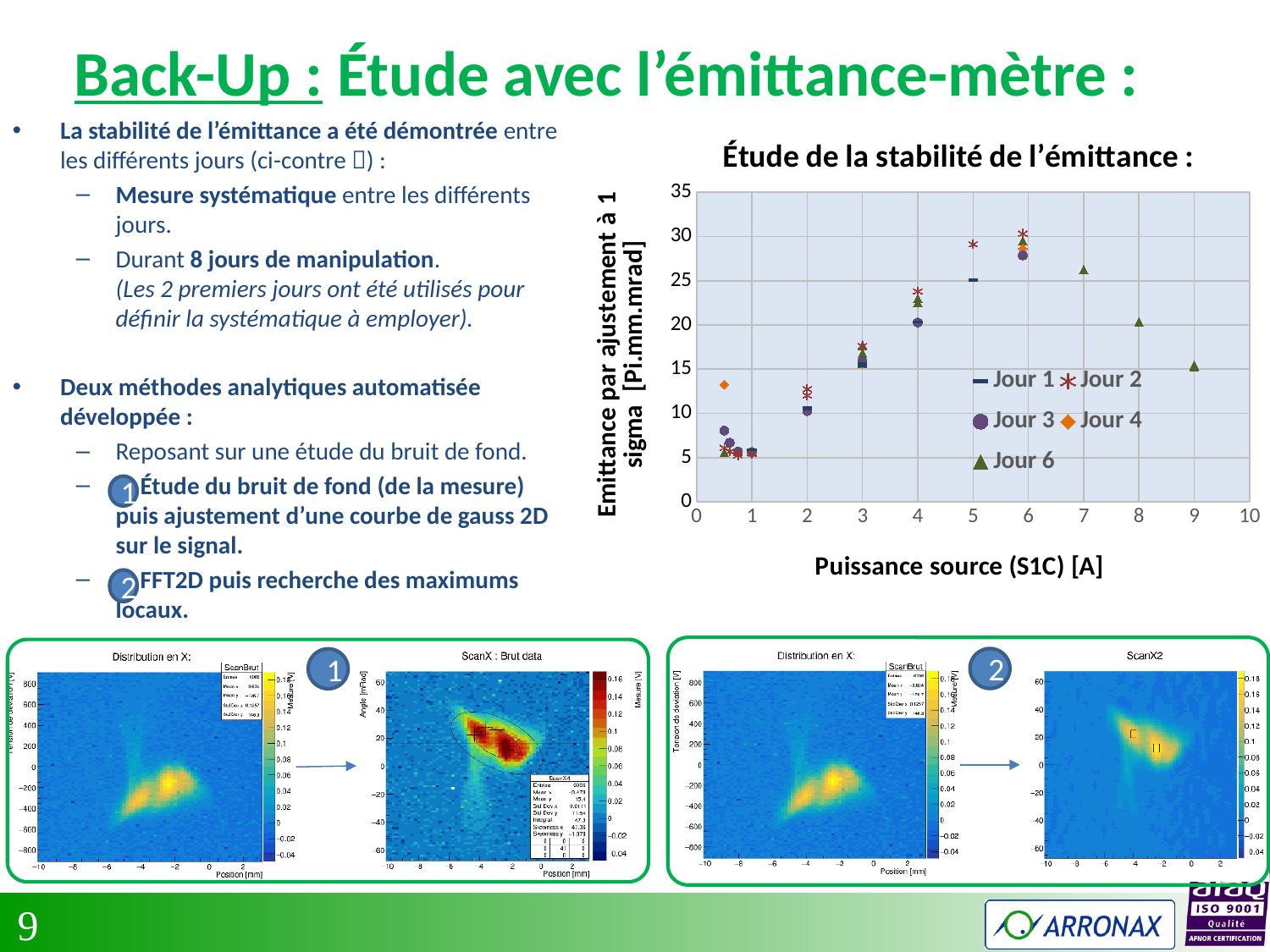
In the 'Étude de la stabilité de l'émittance' chart, do the Jour 2 values rise or fall as the source power increases from 1 to 6? rise In the 'Étude de la stabilité de l'émittance' chart, is the Jour 6 value at x = 7 greater or less than 25? greater What kind of chart is 'Étude de la stabilité de l'émittance'? Scatter chart In the 'Étude de la stabilité de l'émittance' chart, is the Jour 2 value at x = 3 greater or less than 15? greater In the 'Étude de la stabilité de l'émittance' chart, is the Jour 2 value at x = 5 greater or less than 25? greater Which series are listed in the legend of the 'Étude de la stabilité de l'émittance' chart? Jour 1, Jour 2, Jour 3, Jour 4, Jour 6 How many series does the legend of the 'Étude de la stabilité de l'émittance' chart list? 5 In the 'Étude de la stabilité de l'émittance' chart, which is larger: the Jour 6 value at x = 7 or the Jour 6 value at x = 9? x = 7 In the 'Étude de la stabilité de l'émittance' chart, do the Jour 6 values rise or fall as the source power increases from 6 to 9? fall What is the x-axis title of the 'Étude de la stabilité de l'émittance' chart? Puissance source (S1C) [A]